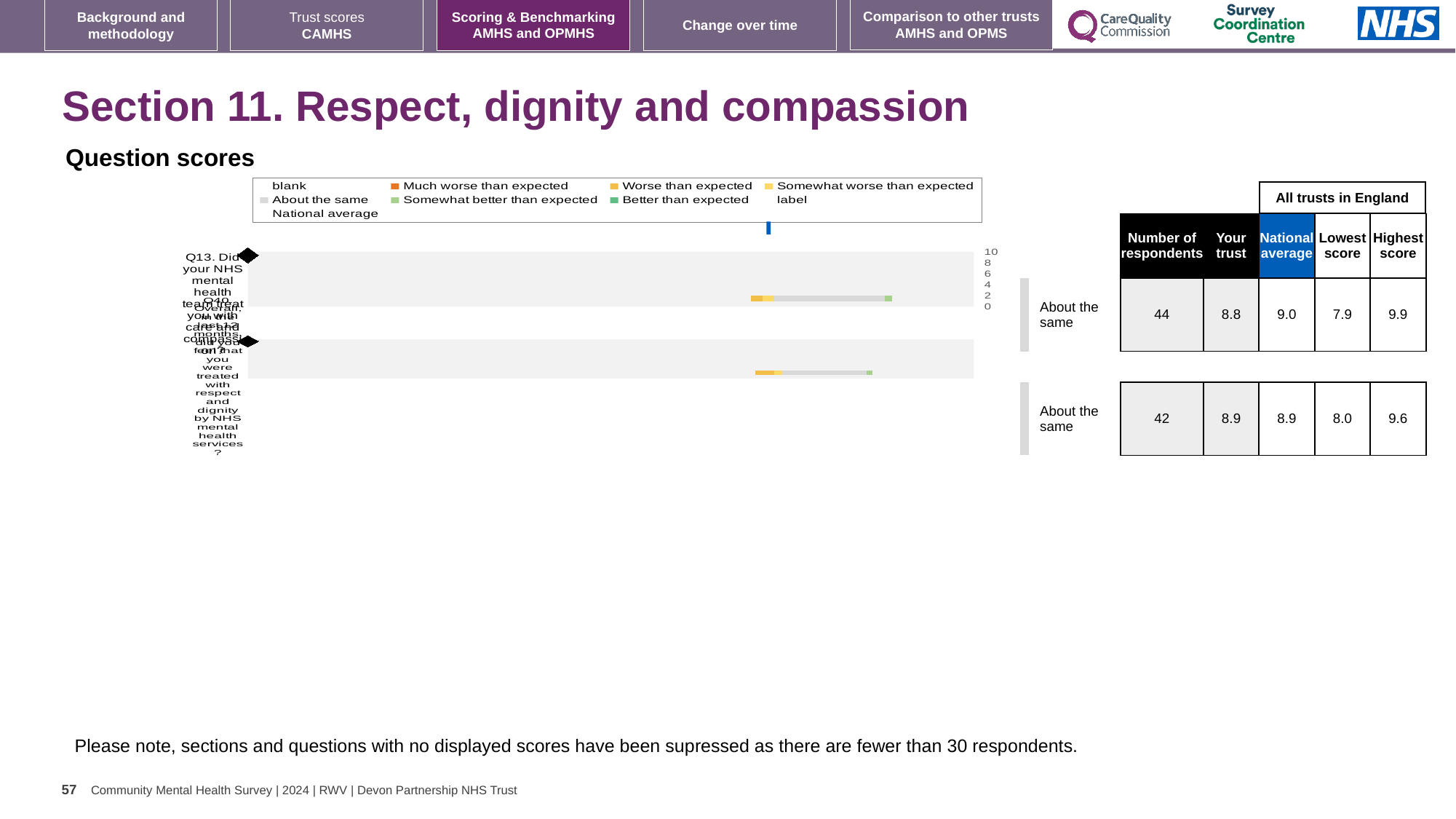
In the table to the right of the 'Question scores' chart, what is the 'Your trust' score for the first row (Q13)? 8.8 In the 'Question scores' chart legend, which entry is shown in orange? Much worse than expected How many questions (categories) are plotted in the 'Question scores' chart? 2 How many entries does the legend of the 'Question scores' chart list? 9 In the table to the right of the 'Question scores' chart, what is the number of respondents for the first row (Q13)? 44 In the table to the right of the 'Question scores' chart, which row has the higher 'Highest score': the first row (Q13) at 9.9 or the second row (Q10) at 9.6? the first row (Q13) In the 'Question scores' chart legend, which entry is shown in dark green? Better than expected What benchmark category is shown next to the Q13 row of the 'Question scores' chart? About the same What kind of chart is shown under 'Question scores'? bar chart In the table to the right of the 'Question scores' chart, what is the 'Your trust' score for the second row (Q10)? 8.9 What is the highest tick value shown on the axis of the 'Question scores' chart? 10 What benchmark category is shown next to the Q10 row of the 'Question scores' chart? About the same